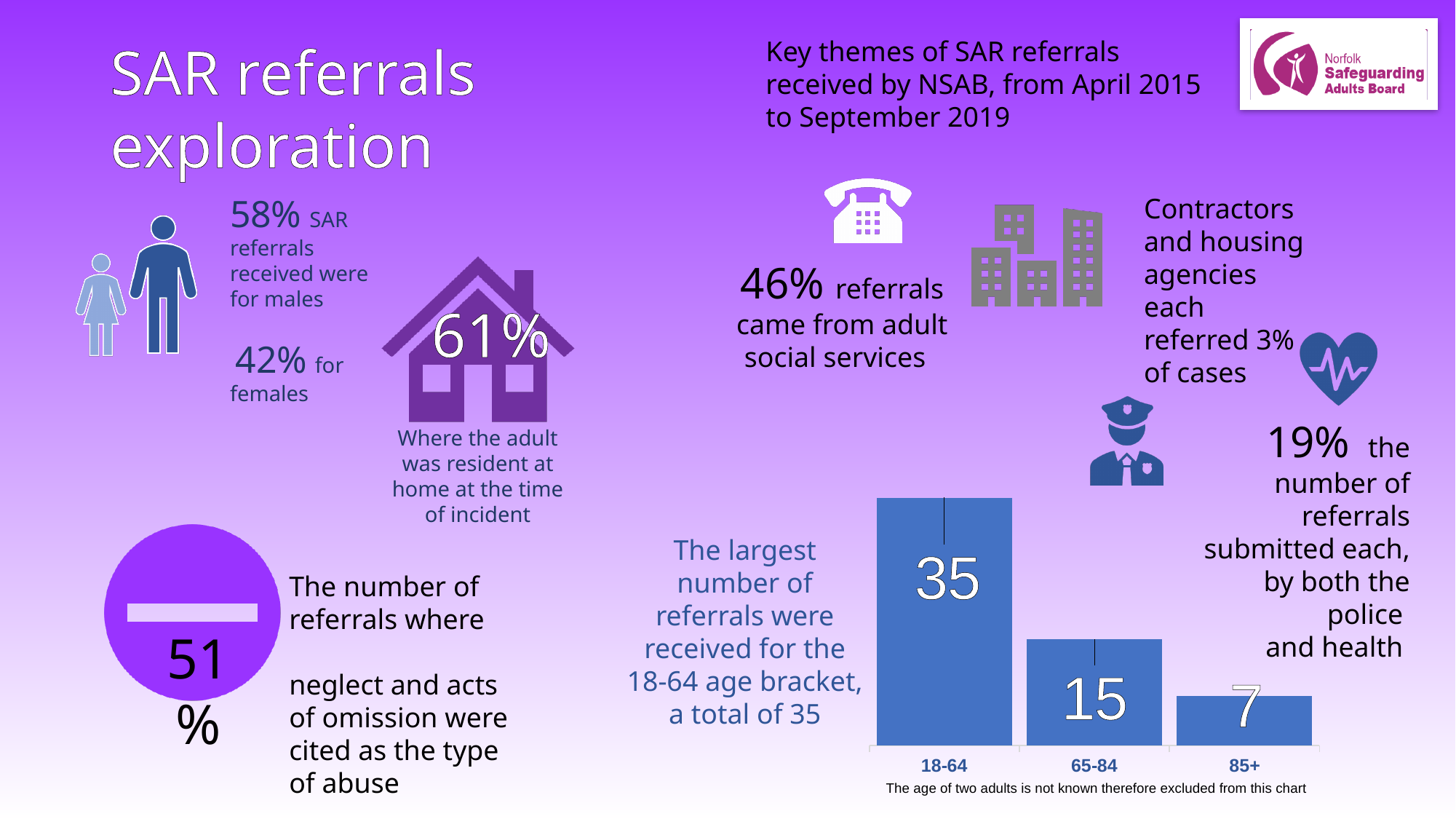
Which age bracket has more referrals, 65-84 or 85+? 65-84 What is the difference in referrals between the 18-64 and 65-84 age brackets? 20 Do the referral values rise or fall as the age brackets increase from 18-64 to 85+? Fall What is the difference in referrals between the 65-84 and 85+ age brackets? 8 What is the number of referrals for the 18-64 age bracket in the bar chart? 35 According to the note under the bar chart, how many adults were excluded because their age is not known? Two How many age brackets are shown in the bar chart? 3 What type of chart is used to show referrals by age bracket? Bar chart Which age bracket has the highest number of referrals in the bar chart? 18-64 What is the number of referrals for the 85+ age bracket in the bar chart? 7 What is the number of referrals for the 65-84 age bracket in the bar chart? 15 Which age bracket has the lowest number of referrals in the bar chart? 85+